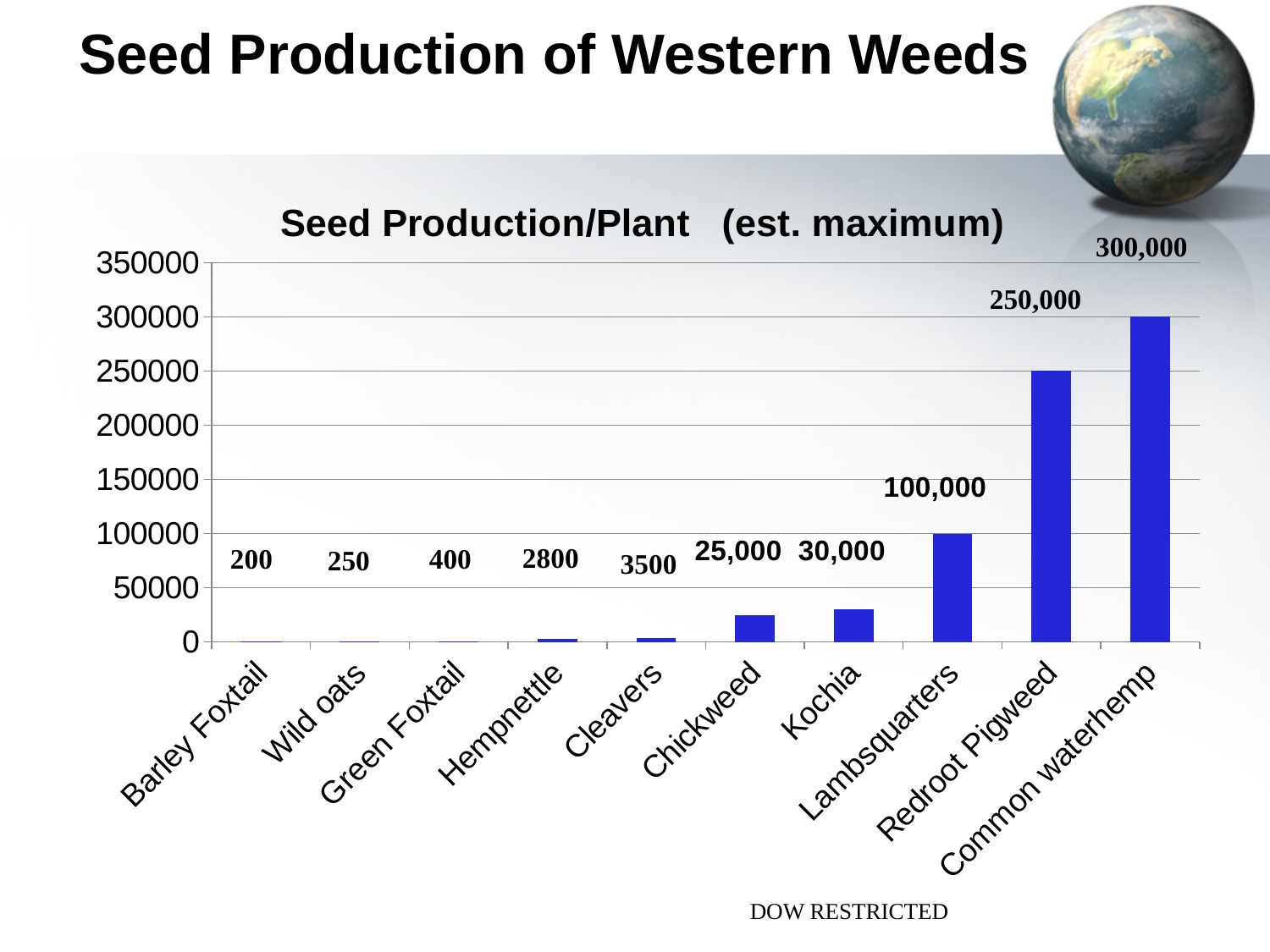
What is the seed production per plant for Hempnettle? 2800 What is the difference in seed production per plant between Kochia and Chickweed? 5,000 Is the value for Lambsquarters greater or less than 150000? less What is the difference in seed production per plant between Common waterhemp and Redroot Pigweed? 50,000 What is the seed production per plant for Redroot Pigweed? 250,000 How many weed species are shown on the chart? 10 Which has a higher seed production per plant, Cleavers or Hempnettle? Cleavers What kind of chart is shown on the slide? Bar chart What is the seed production per plant for Kochia? 30,000 Which weed has the lowest seed production per plant? Barley Foxtail Which weed has the highest seed production per plant? Common waterhemp What is the title of the chart? Seed Production/Plant (est. maximum)